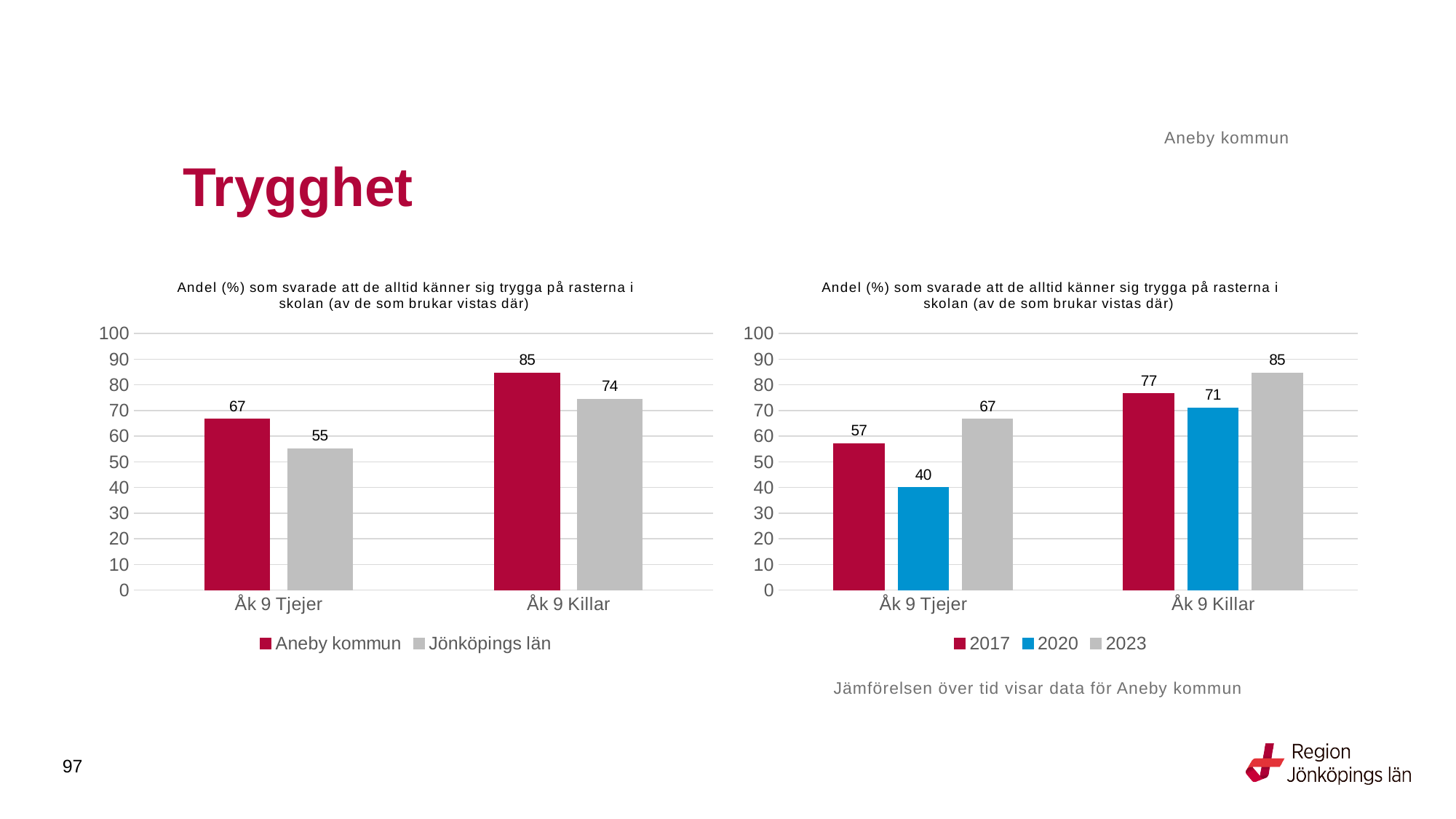
In the right chart, what is the value for 2020 for Åk 9 Tjejer? 40 In the left chart, what is the difference between Aneby kommun and Jönköpings län for Åk 9 Tjejer? 12 In the right chart, do the values for Åk 9 Killar rise or fall from 2020 to 2023? Rise In the left chart, which is larger for Åk 9 Killar: Aneby kommun or Jönköpings län? Aneby kommun In the right chart, what is the difference between the 2023 and 2017 values for Åk 9 Killar? 8 In the left chart, what is the value for Jönköpings län for Åk 9 Killar? 74 In the left chart, what is the value for Aneby kommun for Åk 9 Tjejer? 67 In the right chart, how many series does the legend list? 3 In the right chart, what is the value for 2023 for Åk 9 Killar? 85 In the left chart, how many series does the legend list? 2 What kind of chart is the right chart? Bar chart In the right chart, which year has the lowest value for Åk 9 Tjejer? 2020